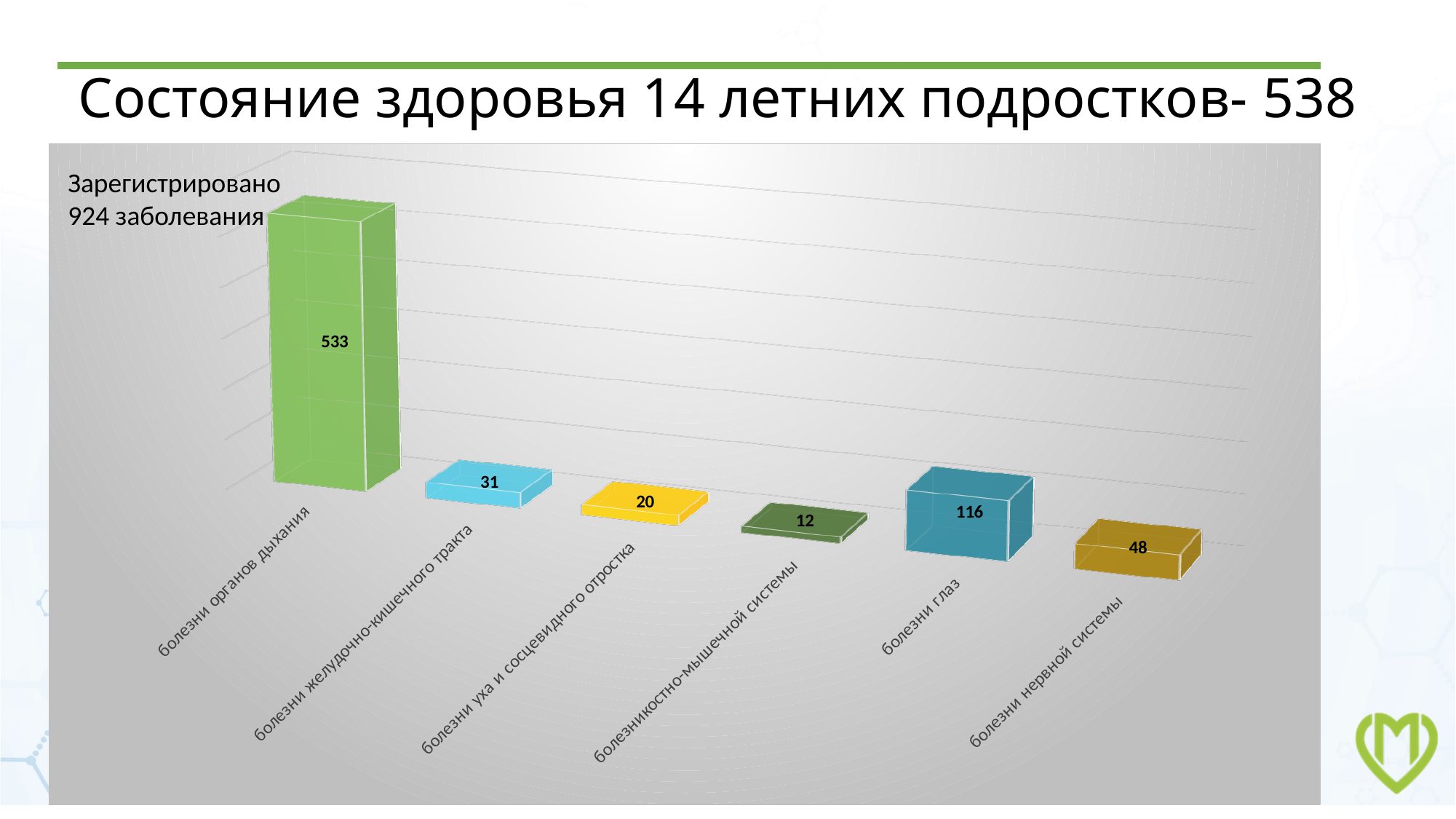
What value is shown for болезни желудочно-кишечного тракта? 31 What is the difference between the values for болезни органов дыхания and болезни глаз? 417 What value is shown for болезни нервной системы? 48 Which category has the lowest value? болезникостно-мышечной системы What value is shown for болезни глаз? 116 What value is shown for болезни органов дыхания? 533 What is the difference between the values for болезни нервной системы and болезни желудочно-кишечного тракта? 17 How many categories are shown in the chart? 6 Which is larger, the value for болезни уха и сосцевидного отростка or the value for болезни нервной системы? болезни нервной системы What total number of registered diseases is stated in the text on the chart? 924 заболевания What kind of chart is shown on the slide? bar chart Which category has the highest value? болезни органов дыхания